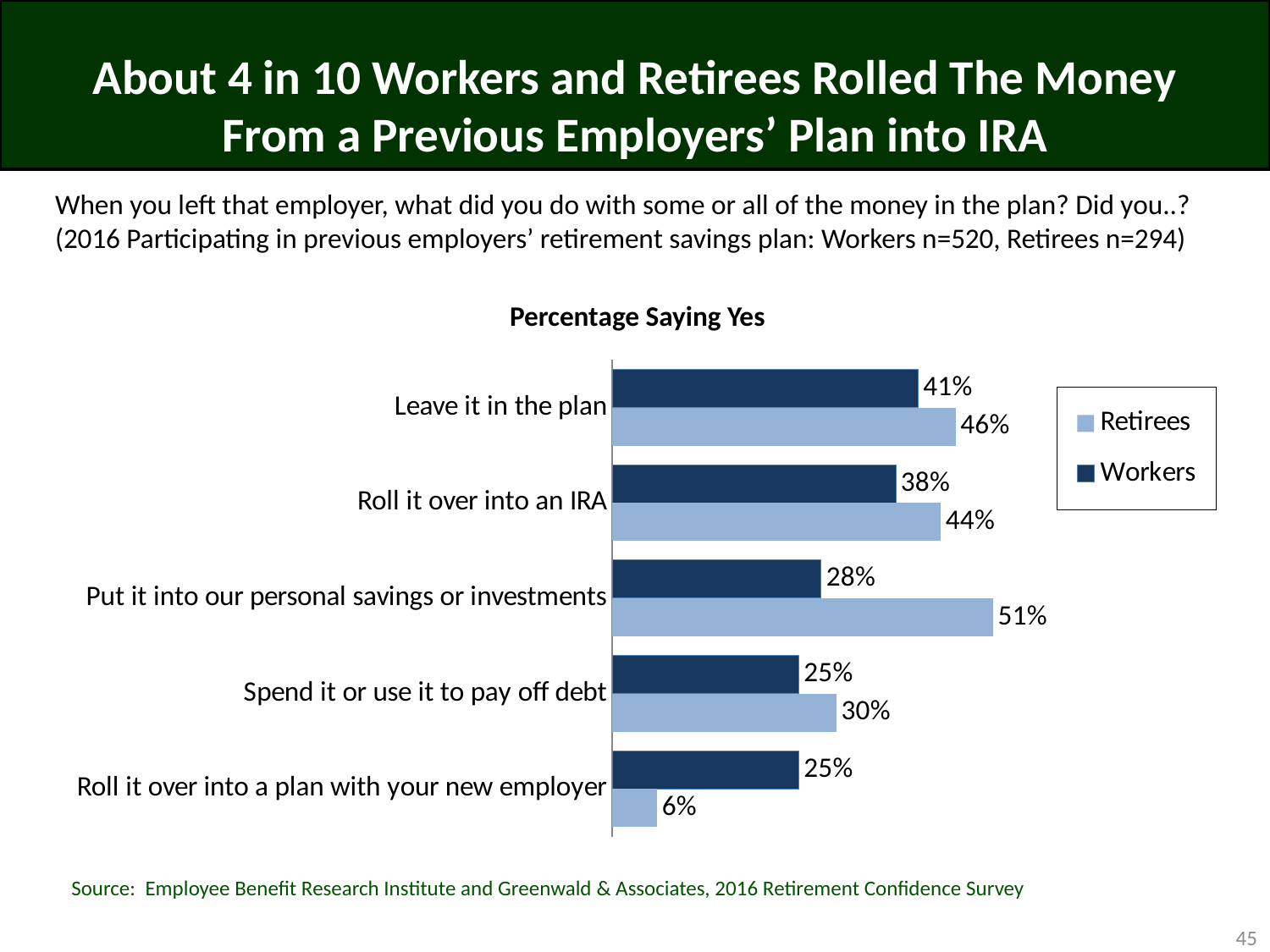
Which category has the highest value for Retirees? Put it into our personal savings or investments How many categories are shown in the chart? 5 Which category has the highest value for Workers? Leave it in the plan What percentage of Retirees said they put it into personal savings or investments? 51% For 'Roll it over into an IRA', which group has the larger value, Workers or Retirees? Retirees What percentage of Retirees said they rolled it over into a plan with their new employer? 6% What type of chart is shown on the slide? Bar chart Which category has the lowest value for Retirees? Roll it over into a plan with your new employer What is the difference between Retirees and Workers for 'Put it into our personal savings or investments'? 23 percentage points For 'Roll it over into a plan with your new employer', which group has the larger value, Workers or Retirees? Workers What percentage of Workers said they would leave it in the plan? 41% How many series does the legend list? 2